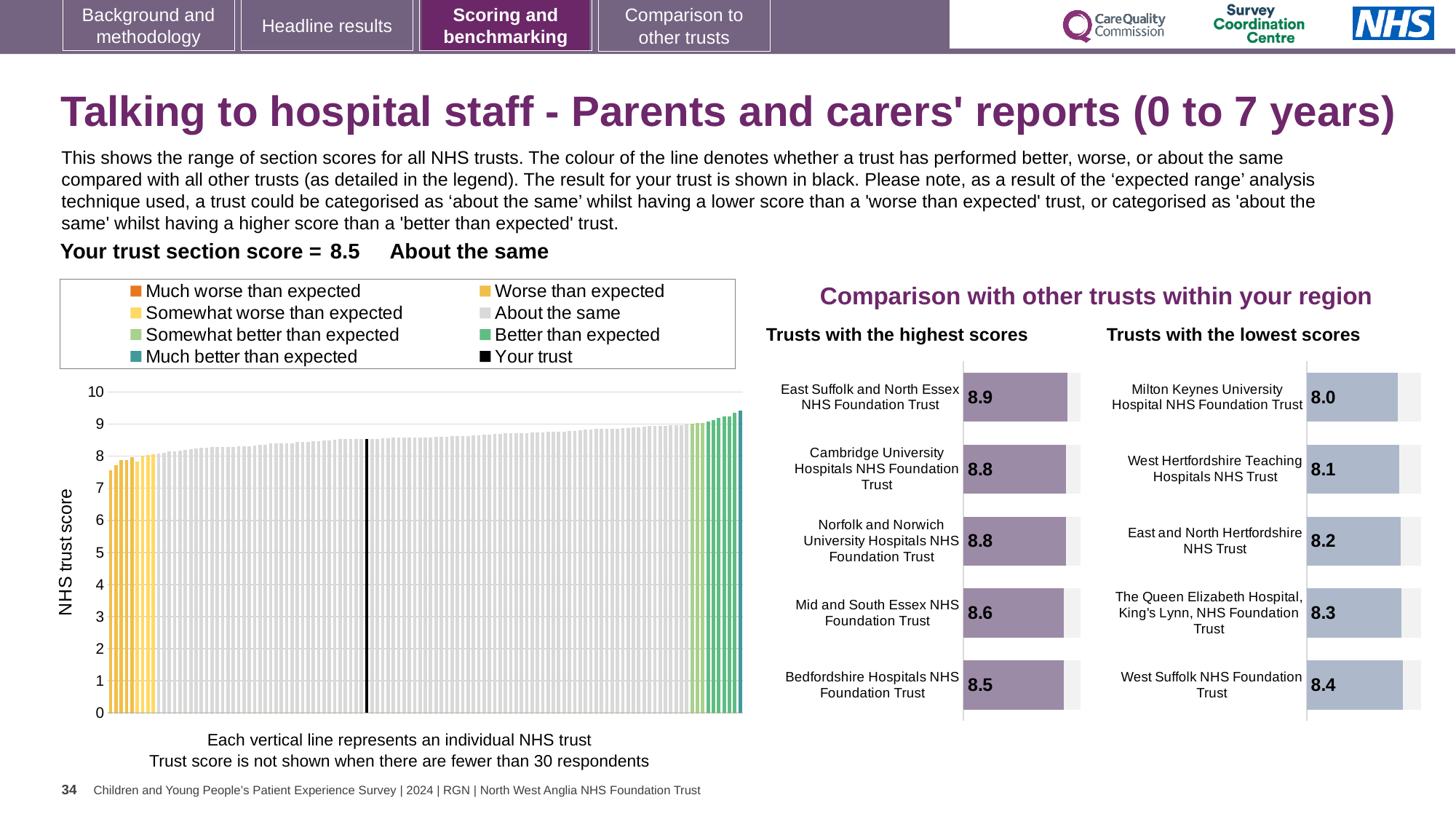
In the 'Trusts with the lowest scores' chart, which trust has the lowest score? Milton Keynes University Hospital NHS Foundation Trust In the large chart on the left, is the value for your trust (the black line) greater or less than 8? greater What kind of chart is the large chart on the left showing all NHS trusts? Bar chart In the 'Trusts with the highest scores' chart, what is the score for East Suffolk and North Essex NHS Foundation Trust? 8.9 Comparing the two regional charts, which has the larger score: Mid and South Essex NHS Foundation Trust or The Queen Elizabeth Hospital, King's Lynn, NHS Foundation Trust? Mid and South Essex NHS Foundation Trust In the 'Trusts with the highest scores' chart, what is the difference between the scores of East Suffolk and North Essex NHS Foundation Trust and Bedfordshire Hospitals NHS Foundation Trust? 0.4 In the large chart on the left, do the trust scores rise or fall from left to right? Rise In the 'Trusts with the lowest scores' chart, what is the score for West Suffolk NHS Foundation Trust? 8.4 In the 'Trusts with the lowest scores' chart, what is the score for Milton Keynes University Hospital NHS Foundation Trust? 8.0 What is the label on the vertical axis of the large chart on the left? NHS trust score In the 'Trusts with the highest scores' chart, which trust has the highest score? East Suffolk and North Essex NHS Foundation Trust How many trusts are shown in the 'Trusts with the lowest scores' chart? 5